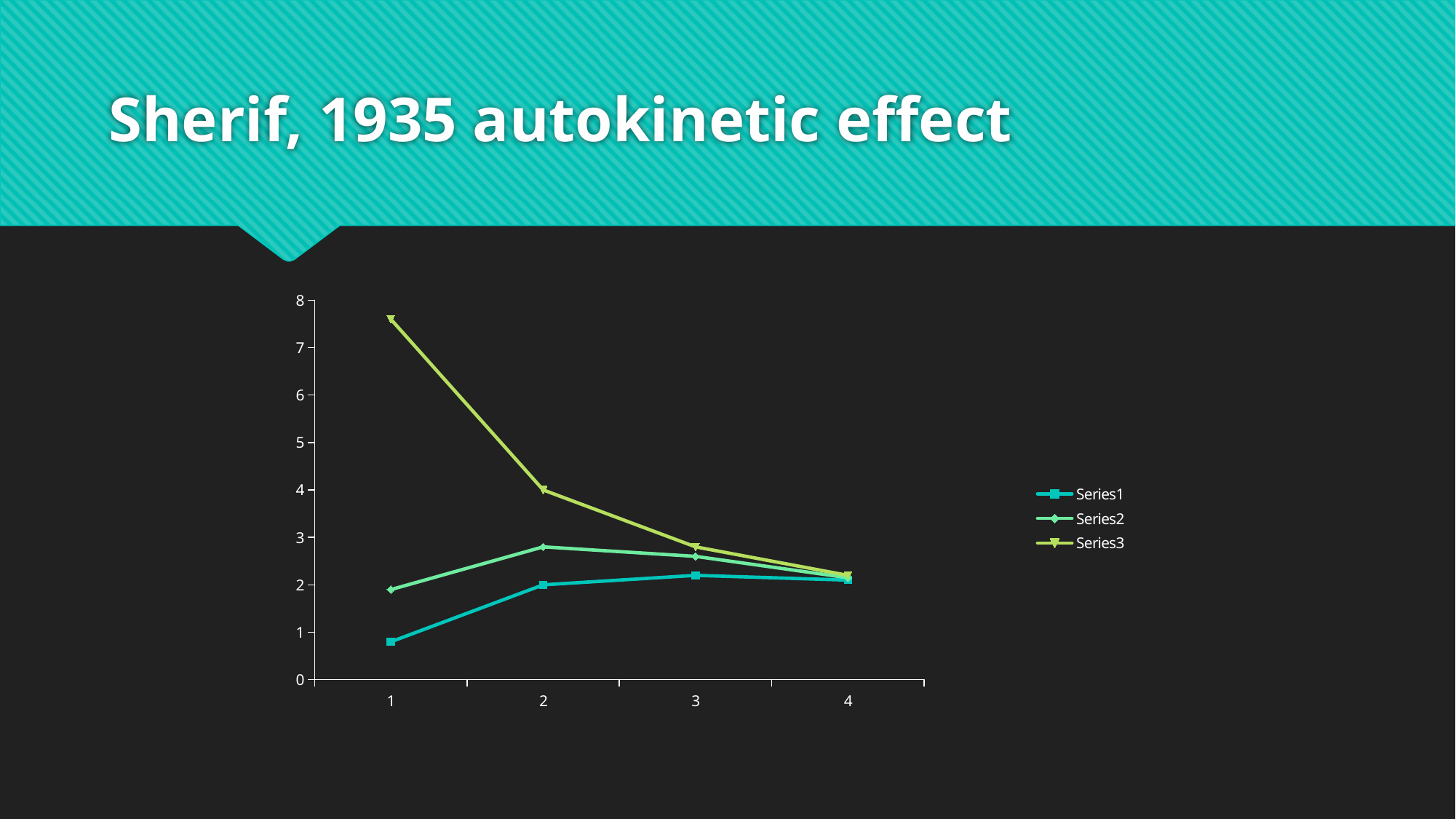
How many series does the legend list? 3 What is the title of the slide containing the chart? Sherif, 1935 autokinetic effect Is the value for Series3 at x = 1 greater or less than 7? greater Is the value for Series1 at x = 1 greater or less than 1? less Does Series1 rise or fall from x = 1 to x = 3? rise At x = 2, which is larger: Series2 or Series1? Series2 Is the value for Series2 at x = 2 greater or less than 3? less Which series has the highest value at x = 1? Series3 Does Series3 rise or fall from x = 1 to x = 4? fall How many points are plotted along the x axis for each series? 4 Which series has the lowest value at x = 1? Series1 What kind of chart is shown on the slide? line chart